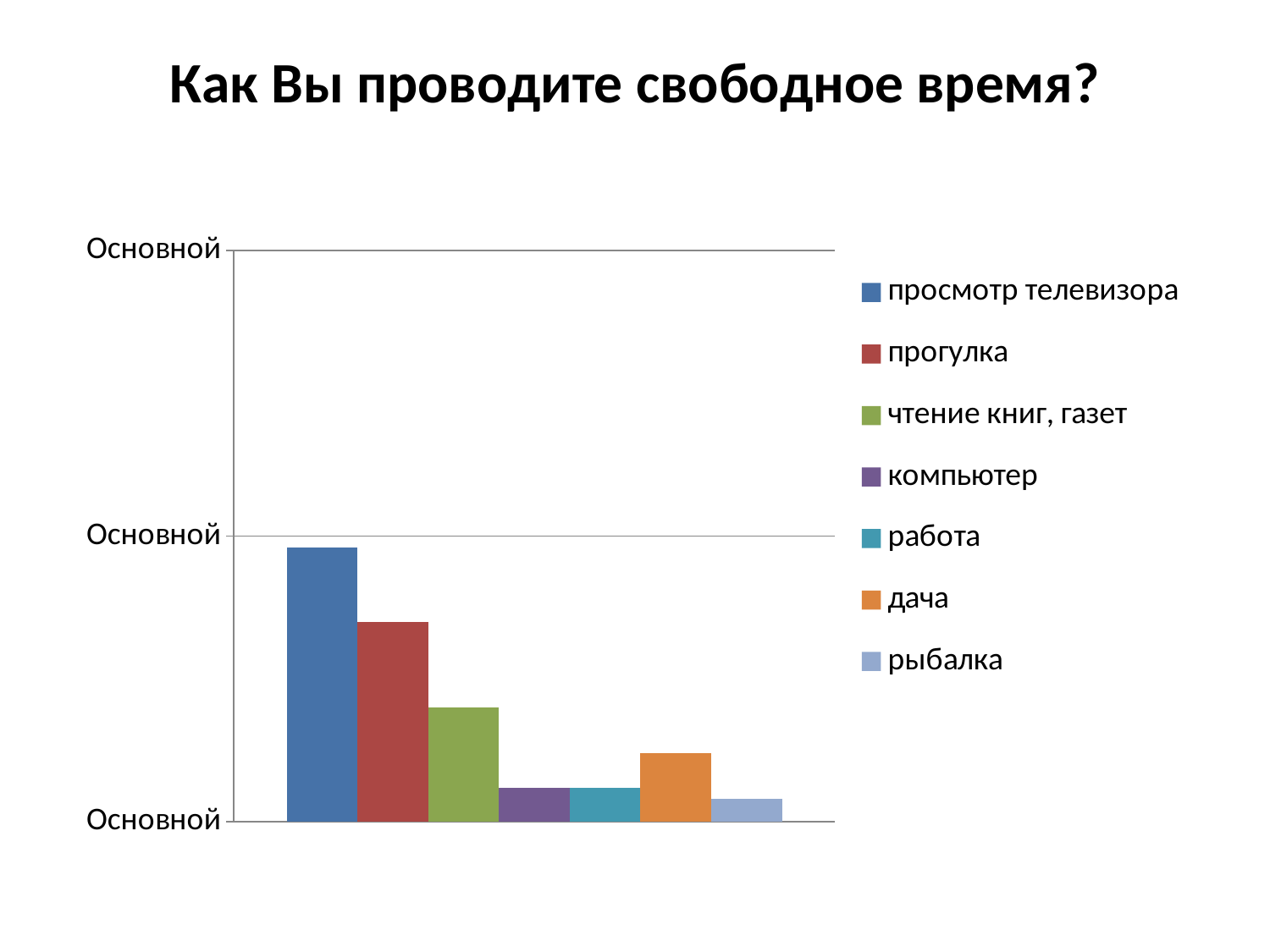
Which is larger, the bar for работа or the bar for рыбалка? работа How many entries does the legend list? 7 Which is larger, the bar for просмотр телевизора or the bar for прогулка? просмотр телевизора Which is larger, the bar for дача or the bar for компьютер? дача Which category has the second-highest bar in the chart? прогулка Which category has the highest bar in the chart? просмотр телевизора Which category has the lowest bar in the chart? рыбалка What colour is the bar for дача? orange How many bars are plotted in the chart? 7 What kind of chart is shown on the slide? bar chart What is the title of the slide? Как Вы проводите свободное время?